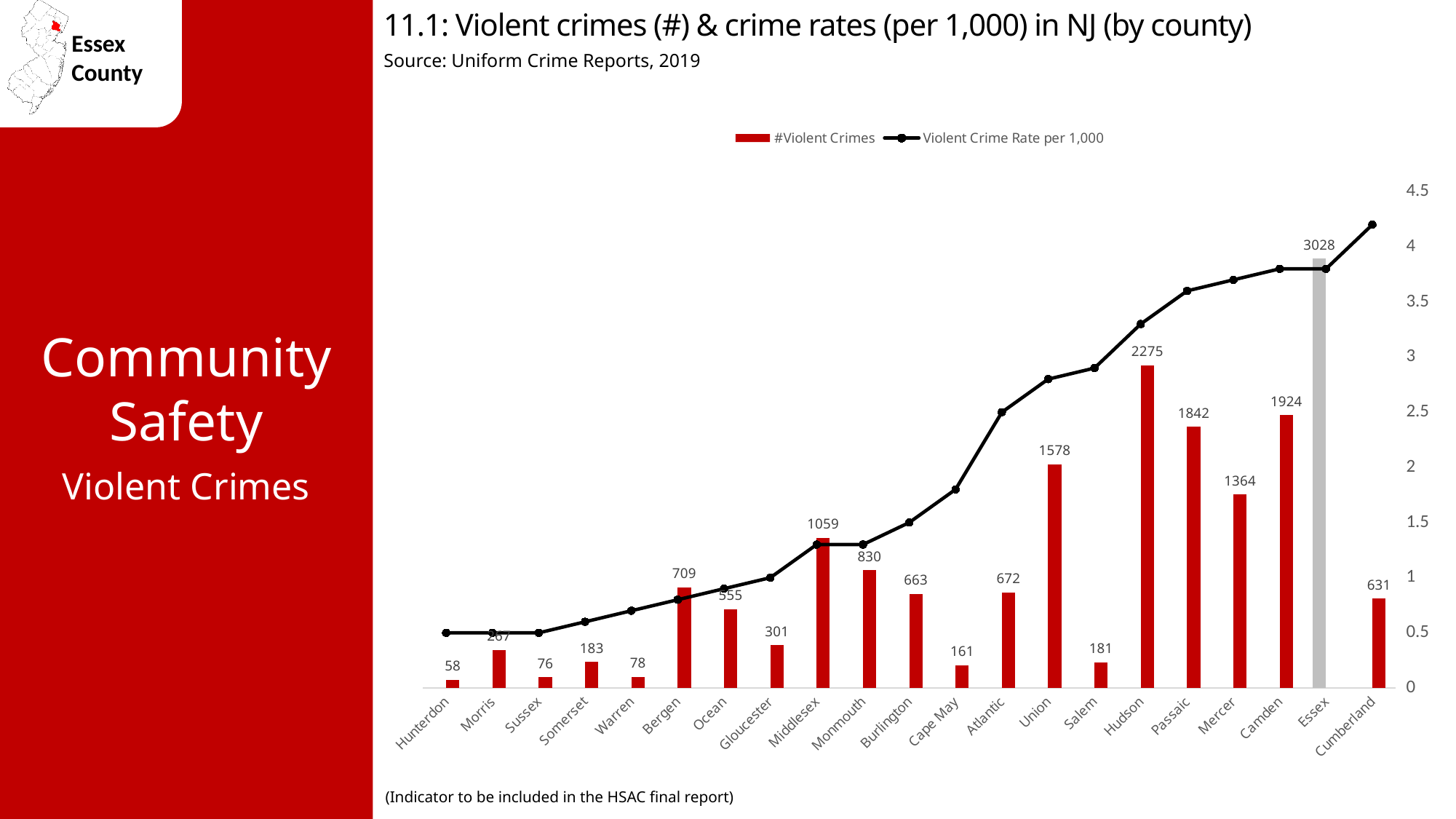
What is the number of violent crimes for Hudson? 2275 Is the violent crime rate per 1,000 for Cumberland greater or less than 4? greater What is the number of violent crimes for Essex? 3028 Which county has more violent crimes, Camden or Passaic? Camden How many series does the legend list? 2 Does the violent crime rate per 1,000 line generally rise or fall from left to right across the counties? rise Which county has the highest number of violent crimes? Essex What is the number of violent crimes for Union? 1578 Is the violent crime rate per 1,000 for Hunterdon greater or less than 1? less Which county has the lowest number of violent crimes? Hunterdon What is the difference in the number of violent crimes between Essex and Hudson? 753 How many counties are shown on the x axis? 21